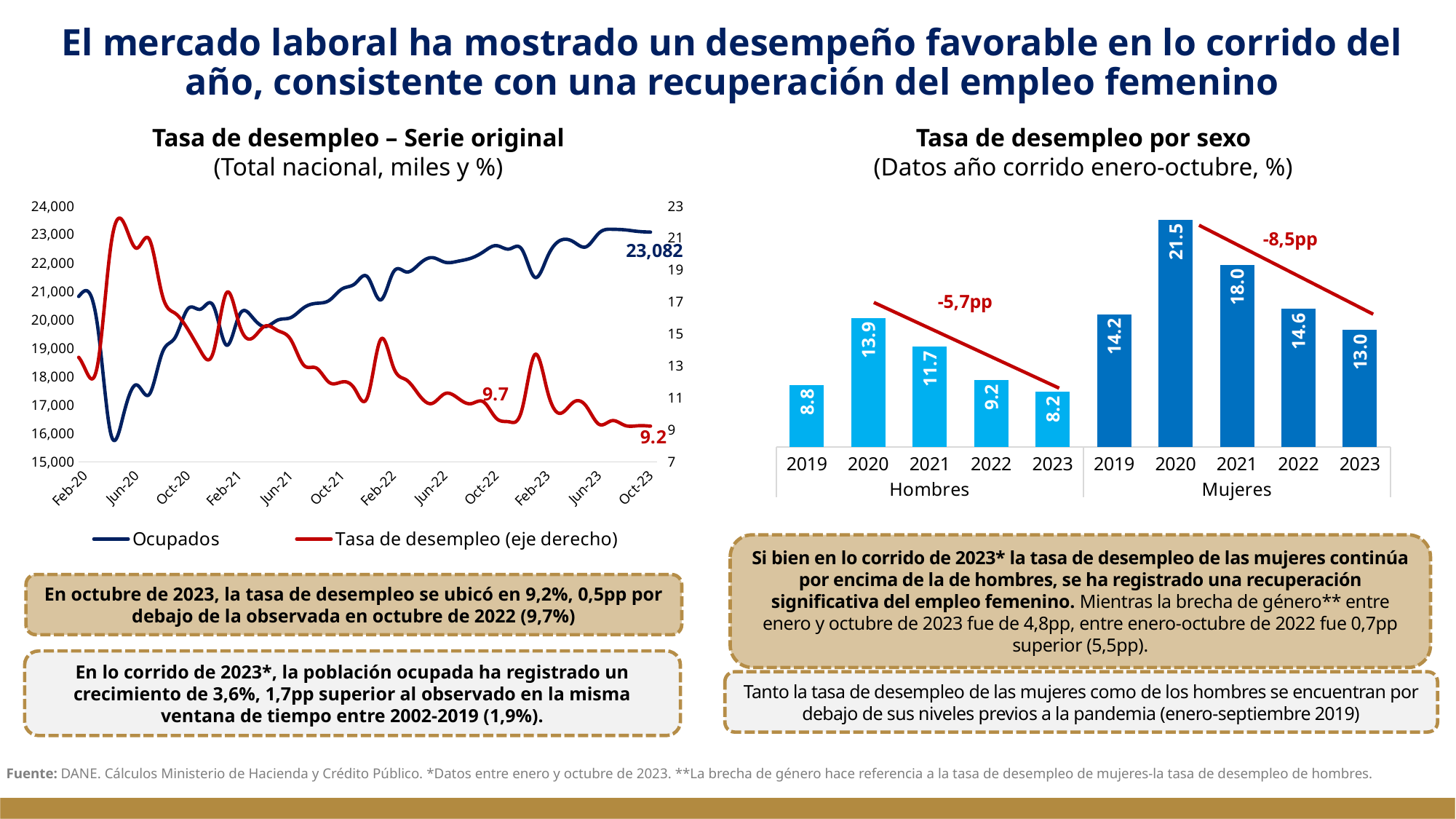
In the 'Tasa de desempleo por sexo' chart, which year has the lowest unemployment rate for Mujeres? 2023 In the 'Tasa de desempleo por sexo' chart, how many bars are plotted in total? 10 In the 'Tasa de desempleo – Serie original' chart, what is the labelled value of Ocupados at Oct-23? 23,082 In the 'Tasa de desempleo por sexo' chart, what is the difference between the Mujeres and Hombres unemployment rates in 2023? 4.8 In the 'Tasa de desempleo por sexo' chart, what is the unemployment rate for Hombres in 2023? 8.2 In the 'Tasa de desempleo – Serie original' chart, what is the labelled unemployment rate at Oct-22? 9.7 What kind of chart is 'Tasa de desempleo por sexo'? Bar chart In the 'Tasa de desempleo por sexo' chart, which is larger: the Hombres rate in 2021 or the Mujeres rate in 2019? Mujeres 2019 In the 'Tasa de desempleo por sexo' chart, which year has the highest unemployment rate for Hombres? 2020 In the 'Tasa de desempleo por sexo' chart, what change in percentage points is annotated above the Mujeres bars? -8,5pp How many series does the legend of the 'Tasa de desempleo – Serie original' chart list? 2 In the 'Tasa de desempleo por sexo' chart, what is the unemployment rate for Mujeres in 2020? 21.5